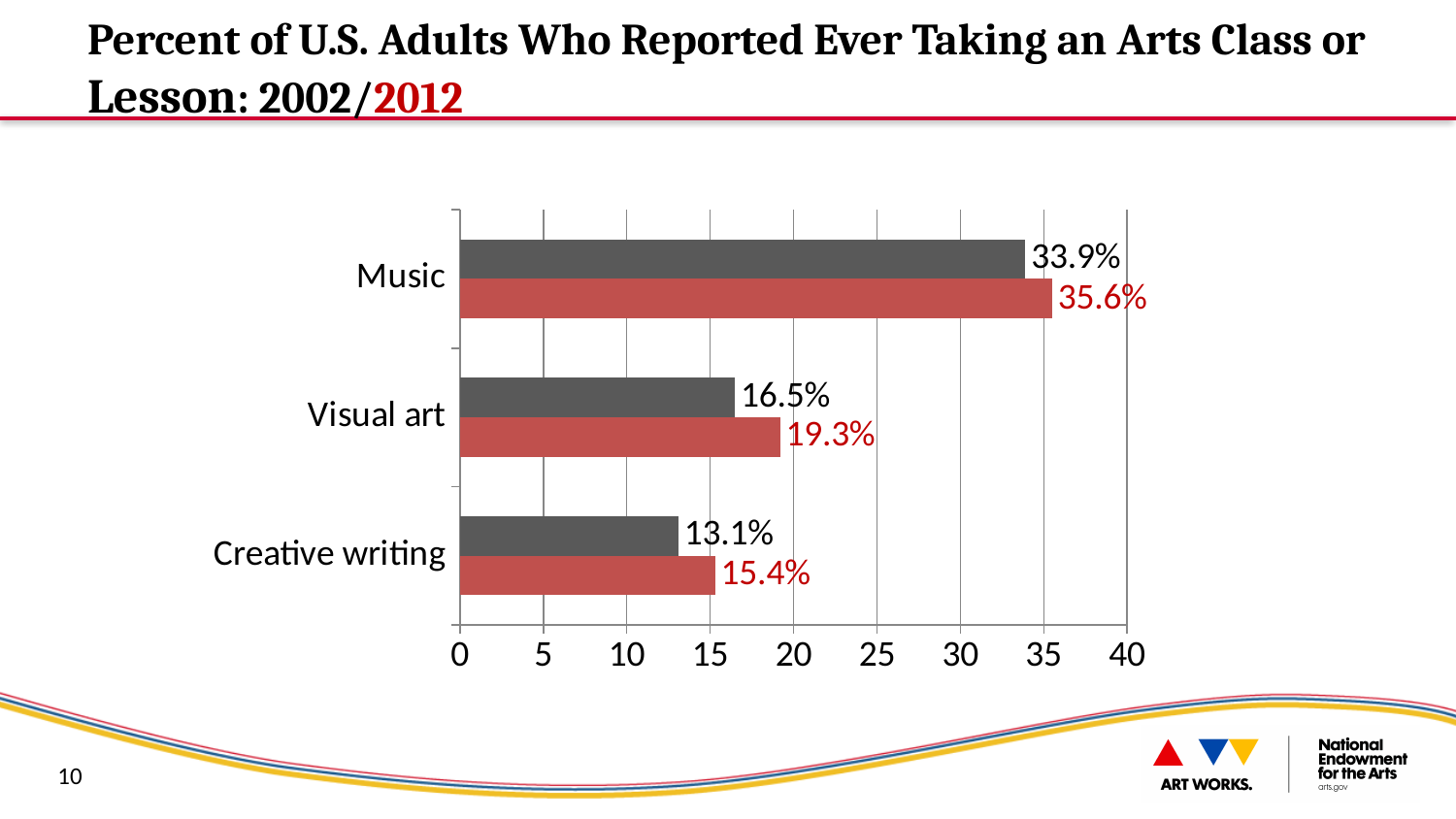
Which category has the lowest value in 2002? Creative writing What colour are the bars representing 2012? Red What is the difference between the 2012 values for Music and Creative writing? 20.2 What percent of U.S. adults reported ever taking a music class or lesson in 2012? 35.6% By how many percentage points did the Visual art value increase from 2002 to 2012? 2.8 What is the 2012 value for Creative writing? 15.4% What type of chart is shown on the slide? Bar chart What is the 2002 value for Music? 33.9% How many categories are shown on the chart? 3 Which category has the highest value in 2012? Music What percent of U.S. adults reported ever taking a visual art class or lesson in 2002? 16.5% Which is larger: the 2002 value for Visual art or the 2012 value for Creative writing? 2002 value for Visual art